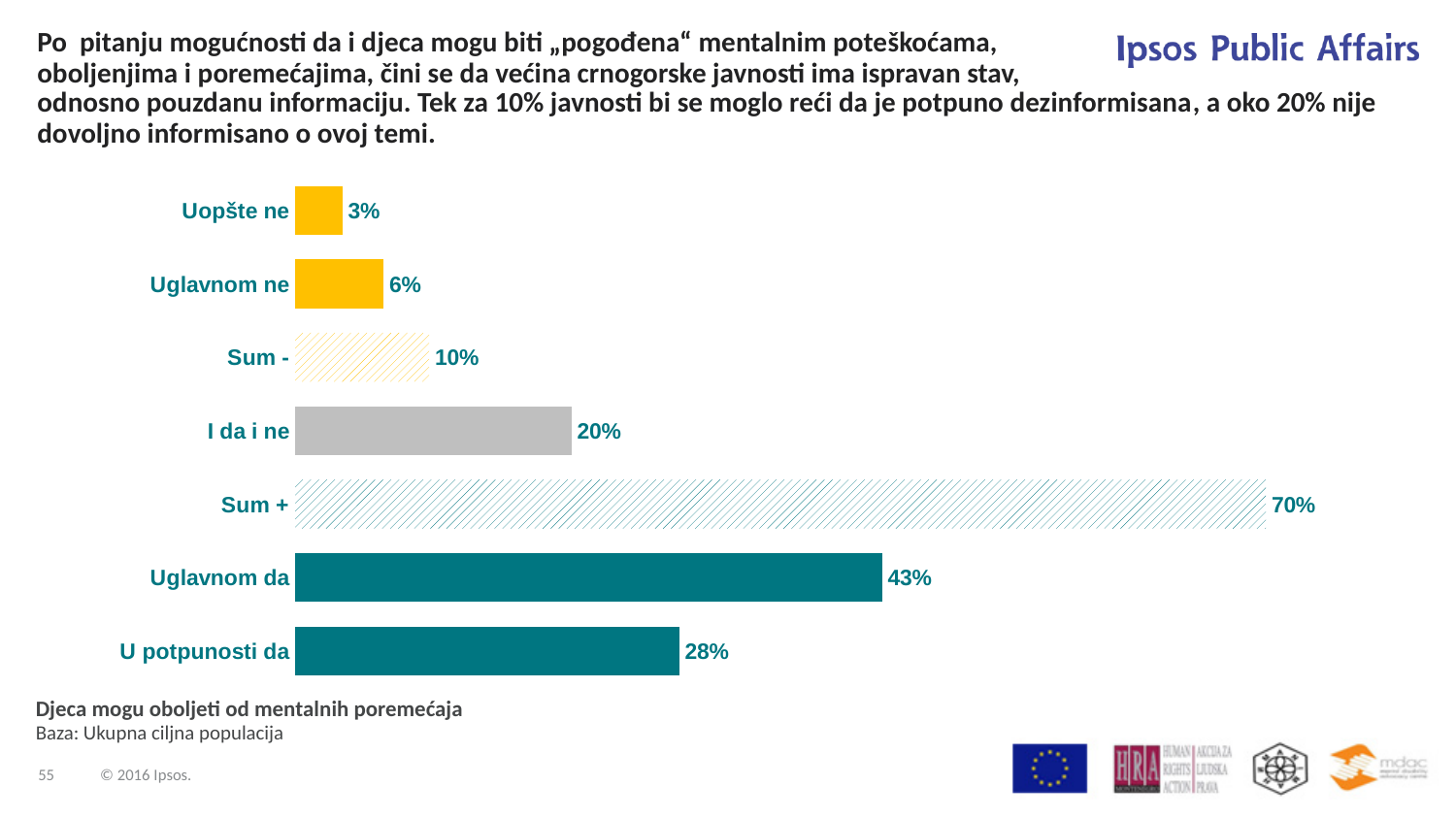
Which category has the highest value? Sum + What is the value for "Sum +"? 70% What is the value for "Uopšte ne"? 3% What is the difference between "Uglavnom da" and "U potpunosti da"? 15% What is the title printed below the chart? Djeca mogu oboljeti od mentalnih poremećaja Which category has the lowest value? Uopšte ne What is the value for "U potpunosti da"? 28% What is the value for "I da i ne"? 20% What kind of chart is shown on the slide? Bar chart How many categories are shown in the chart? 7 Which is larger, "Uglavnom ne" or "I da i ne"? I da i ne What is the value for "Uglavnom da"? 43%